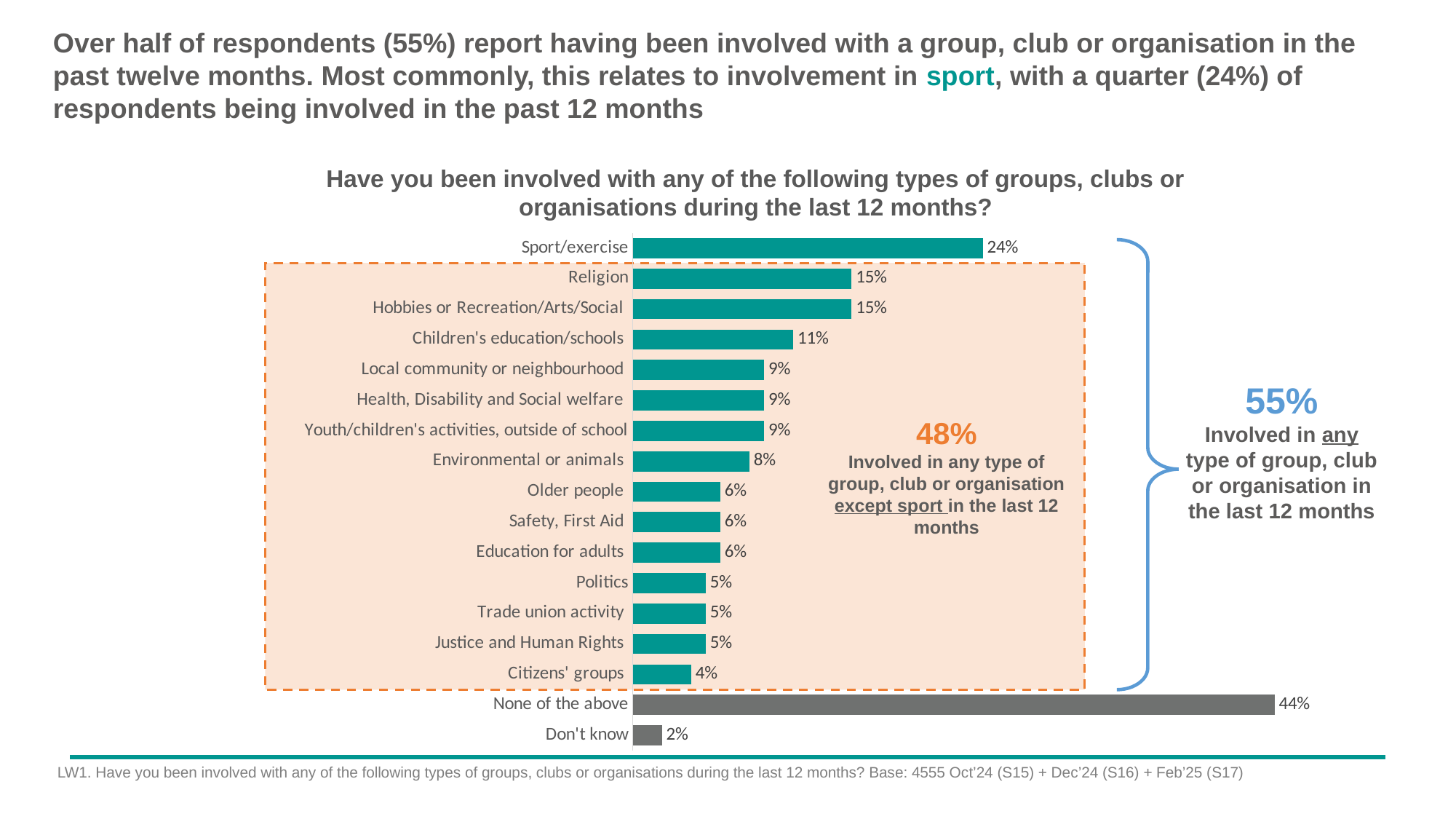
What is the value shown for Children's education/schools? 11% What is the value for Citizens' groups? 4% Which category has the lowest value on the chart? Don't know Which is larger, the value for Environmental or animals or the value for Older people? Environmental or animals How many categories are shown on the chart? 17 What is the difference between the values for Sport/exercise and Religion? 9 percentage points What percentage of respondents selected None of the above? 44% What percentage of respondents were involved in Sport/exercise groups? 24% What percentage is shown in the orange dashed box for involvement in any type of group, club or organisation except sport? 48% What is the value for Hobbies or Recreation/Arts/Social? 15% What kind of chart is shown on the slide? Bar chart Which type of group, club or organisation has the highest percentage of involvement? Sport/exercise